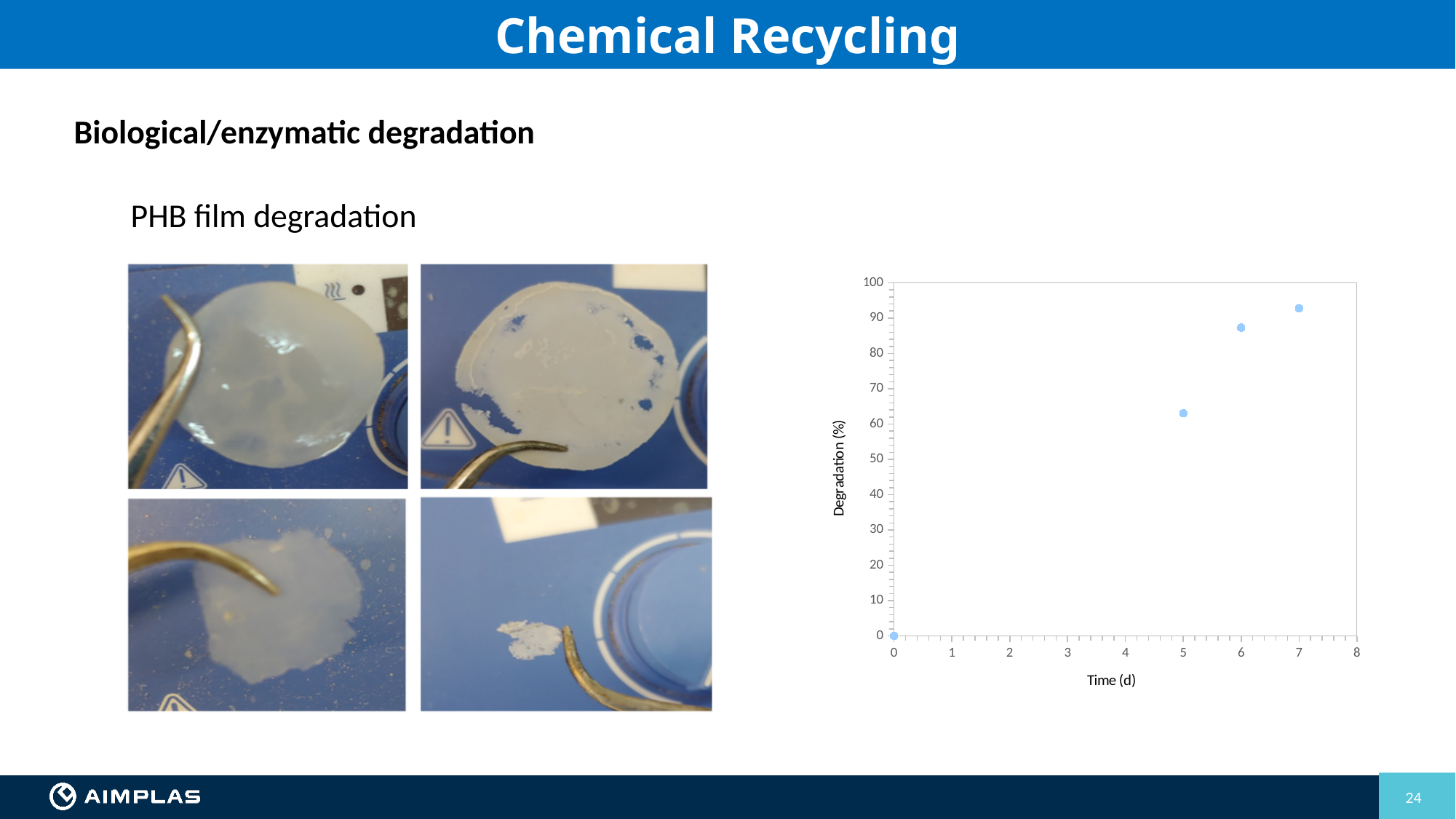
Do the degradation values rise or fall as time increases along the x axis? rise How many data points are plotted on the chart? 4 What is the label of the x axis of the chart? Time (d) Is the degradation value at 5 d greater or less than 70? less Which has the larger degradation value, 5 d or 6 d? 6 d What kind of chart is shown on the slide? scatter chart Is the degradation value at 5 d greater or less than 50? greater What is the degradation value at time 0 d? 0 At which time is the degradation lowest? 0 d What is the label of the y axis of the chart? Degradation (%) At which time is the degradation highest? 7 d Is the degradation value at 6 d greater or less than 80? greater